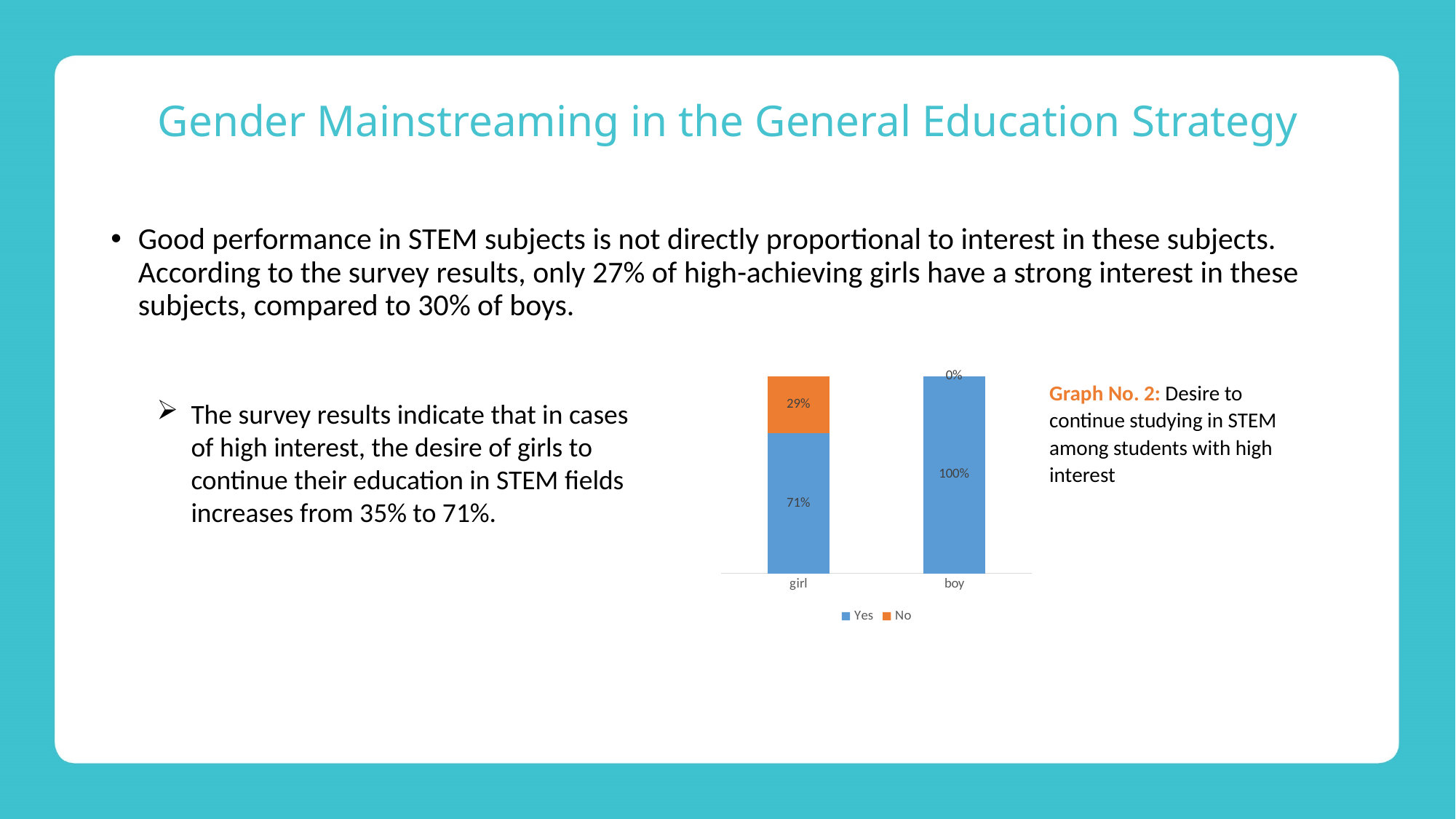
What kind of chart is shown? stacked bar chart What is the difference between the "Yes" values for boy and girl? 29% Which category has the higher "Yes" value, girl or boy? boy Which colour represents the "No" series in the legend? orange What is the "No" value for boy? 0% How many series does the legend list? 2 What is the "No" value for girl? 29% Which category has the highest "No" value? girl How many categories are shown on the x axis? 2 What is the "Yes" value for boy? 100% What is the "Yes" value for girl? 71% What is the total of the stacked bar for girl? 100%